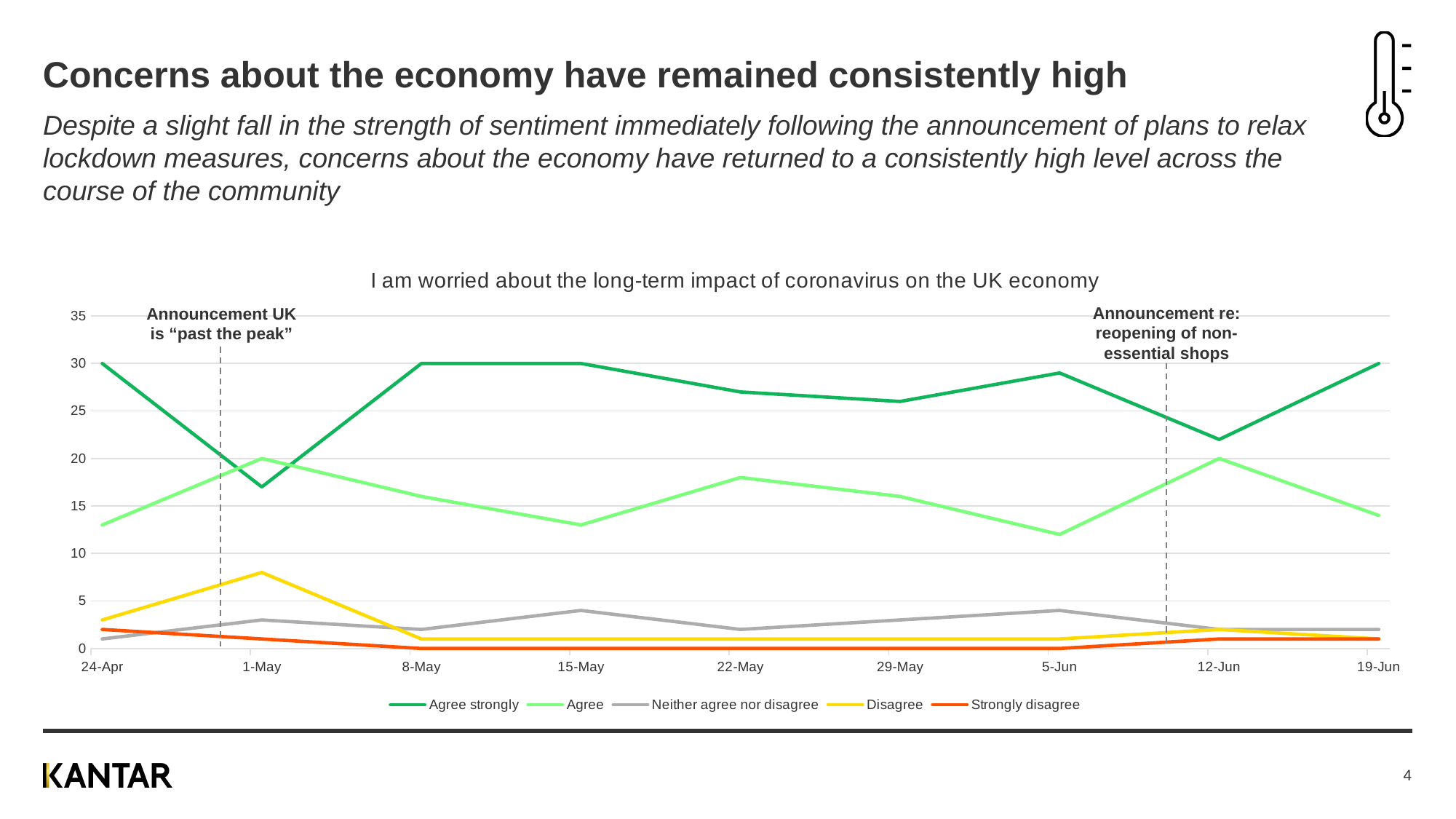
How many dates are shown along the x axis? 9 Does the Agree strongly series rise or fall between 5-Jun and 12-Jun? fall Is the value for Disagree on 1-May greater or less than 5? greater What is the value for Agree on 1-May? 20 On 15-May, which is larger: Agree strongly or Agree? Agree strongly What is the title of the chart? I am worried about the long-term impact of coronavirus on the UK economy How many series does the legend list? 5 Is the value for Agree strongly on 1-May greater or less than 20? less What is the value for Agree strongly on 24-Apr? 30 On which date is the Disagree series at its highest? 1-May What is the value for Agree on 12-Jun? 20 What kind of chart is shown on the slide? line chart